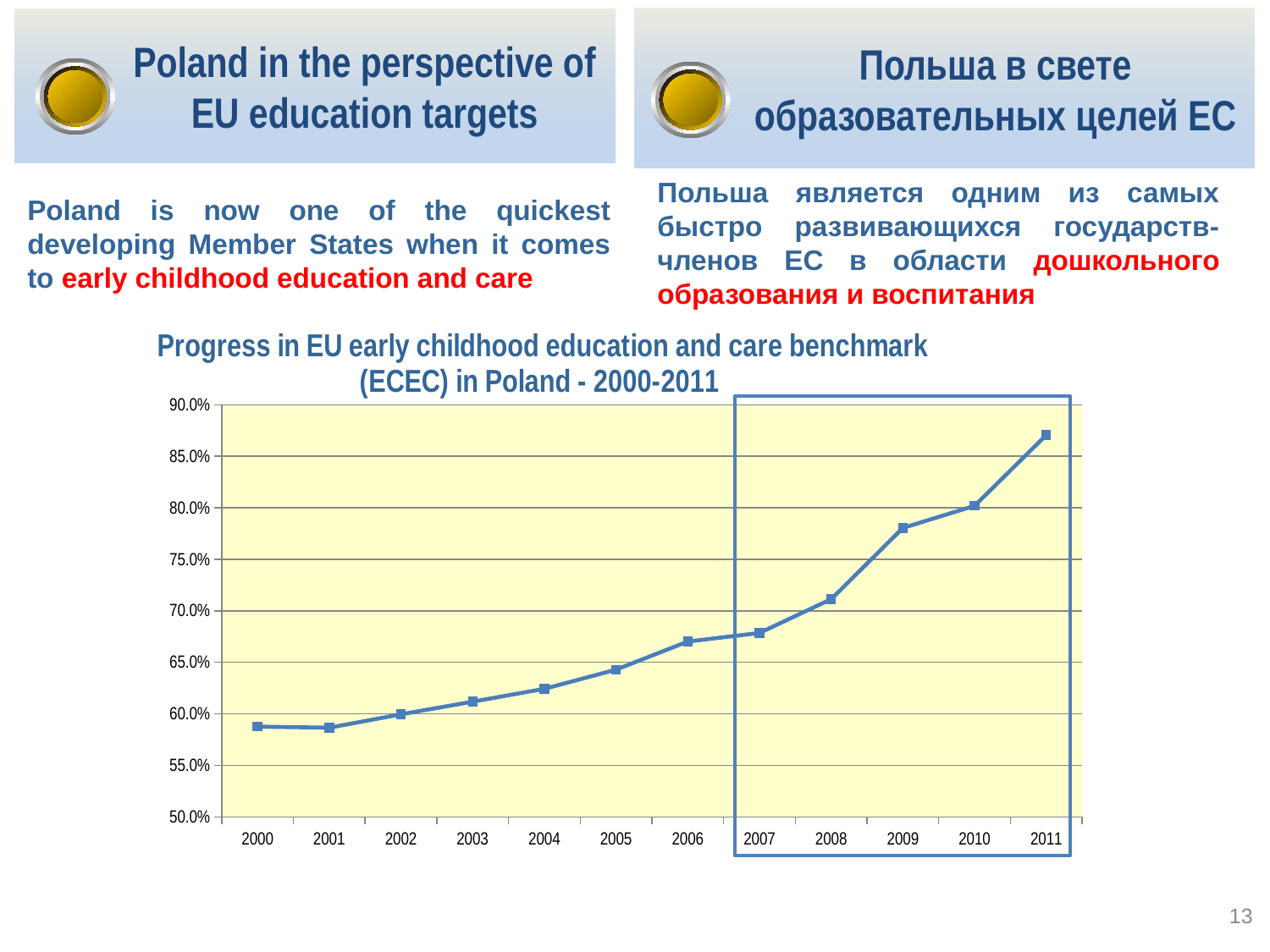
Is the value for 2011 greater or less than 85.0%? greater How many years are plotted on the x axis of the chart? 12 Which year has the larger value, 2006 or 2009? 2009 What kind of chart is shown on the slide? line chart Is the value for 2005 greater or less than 65.0%? less What is the title of the chart? Progress in EU early childhood education and care benchmark (ECEC) in Poland - 2000-2011 Is the value for 2009 greater or less than 75.0%? greater Which year has the highest value in the chart? 2011 Which year has the larger value, 2003 or 2010? 2010 Do the values generally rise or fall from 2000 to 2011? rise